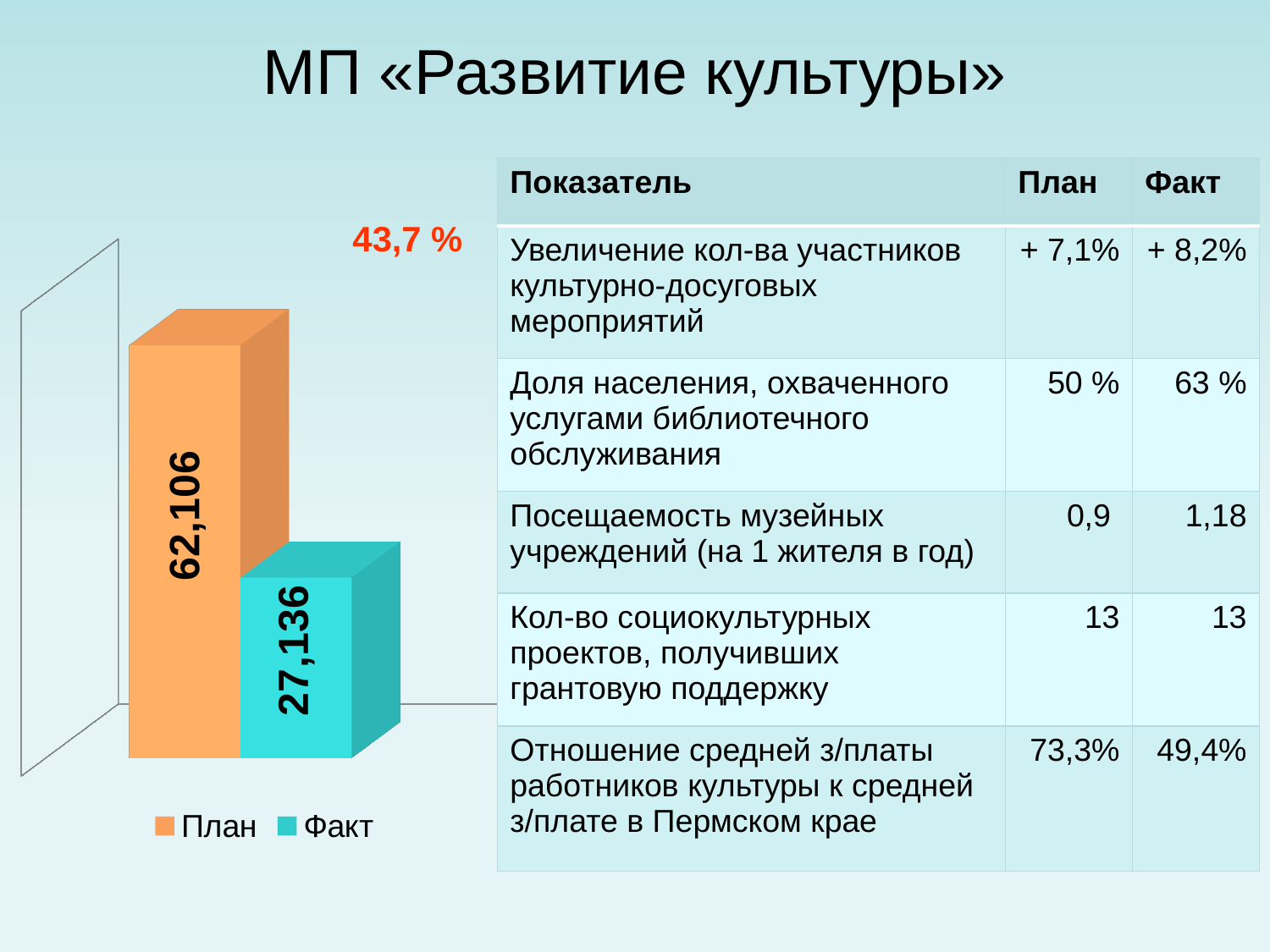
What is the value of the План bar in the chart? 62,106 Which bar in the chart is higher, План or Факт? План How many series does the chart legend list? 2 What colour is the Факт bar in the chart? turquoise What is the difference between the План and Факт values in the chart? 34,970 What kind of chart is shown on the slide? bar chart Which series has the highest value in the chart? План How many bars are plotted in the chart? 2 Which series has the lowest value in the chart? Факт What percentage is printed in red above the chart? 43,7 % What is the value of the Факт bar in the chart? 27,136